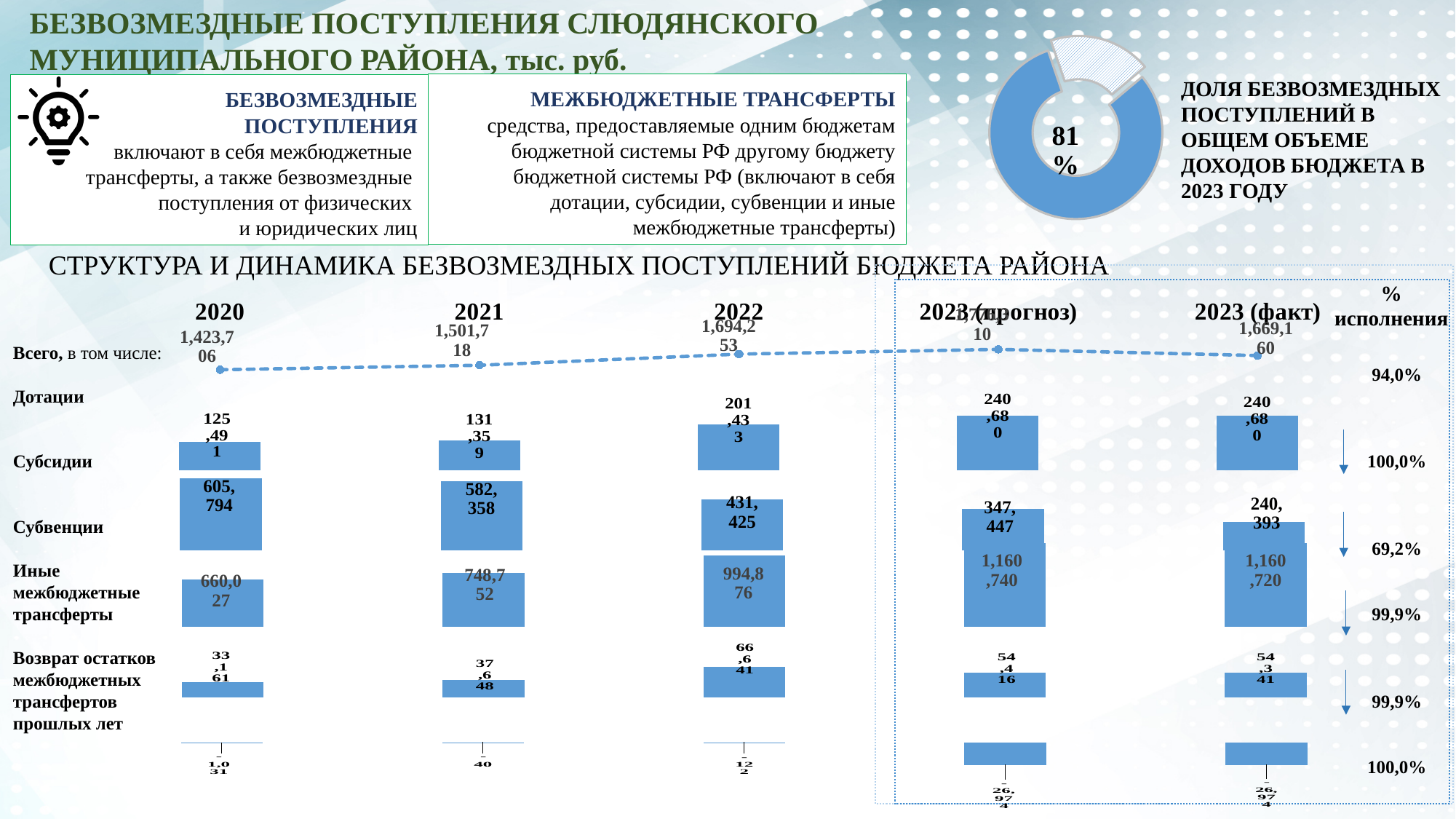
In the chart 'СТРУКТУРА И ДИНАМИКА БЕЗВОЗМЕЗДНЫХ ПОСТУПЛЕНИЙ БЮДЖЕТА РАЙОНА', which is larger for 'Субсидии': 2023 (прогноз) or 2023 (факт)? 2023 (прогноз) On the donut chart at the top right, what share of total budget revenue in 2023 do gratuitous receipts (безвозмездные поступления) make up? 81% In the chart 'СТРУКТУРА И ДИНАМИКА БЕЗВОЗМЕЗДНЫХ ПОСТУПЛЕНИЙ БЮДЖЕТА РАЙОНА', what is the lowest '% исполнения' value shown? 69,2% In the chart 'СТРУКТУРА И ДИНАМИКА БЕЗВОЗМЕЗДНЫХ ПОСТУПЛЕНИЙ БЮДЖЕТА РАЙОНА', what is the 'Дотации' value for 2022? 201,433 What kind of chart is 'СТРУКТУРА И ДИНАМИКА БЕЗВОЗМЕЗДНЫХ ПОСТУПЛЕНИЙ БЮДЖЕТА РАЙОНА'? Bar chart (with a line for 'Всего') In the chart 'СТРУКТУРА И ДИНАМИКА БЕЗВОЗМЕЗДНЫХ ПОСТУПЛЕНИЙ БЮДЖЕТА РАЙОНА', what is the 'Всего' value for 2023 (факт)? 1,669,160 In the chart 'СТРУКТУРА И ДИНАМИКА БЕЗВОЗМЕЗДНЫХ ПОСТУПЛЕНИЙ БЮДЖЕТА РАЙОНА', what is the 'Всего' value for 2020? 1,423,706 In the chart 'СТРУКТУРА И ДИНАМИКА БЕЗВОЗМЕЗДНЫХ ПОСТУПЛЕНИЙ БЮДЖЕТА РАЙОНА', what is the '% исполнения' for 'Всего'? 94,0% What kind of chart is shown at the top right of the slide next to the text 'ДОЛЯ БЕЗВОЗМЕЗДНЫХ ПОСТУПЛЕНИЙ'? Donut (pie) chart How many year columns (periods) are shown in the chart 'СТРУКТУРА И ДИНАМИКА БЕЗВОЗМЕЗДНЫХ ПОСТУПЛЕНИЙ БЮДЖЕТА РАЙОНА'? 5 In the chart 'СТРУКТУРА И ДИНАМИКА БЕЗВОЗМЕЗДНЫХ ПОСТУПЛЕНИЙ БЮДЖЕТА РАЙОНА', by how much did 'Субсидии' decrease from 2020 (605,794) to 2021 (582,358)? 23,436 In the chart 'СТРУКТУРА И ДИНАМИКА БЕЗВОЗМЕЗДНЫХ ПОСТУПЛЕНИЙ БЮДЖЕТА РАЙОНА', does the 'Всего' line rise or fall from 2020 to 2022? Rises